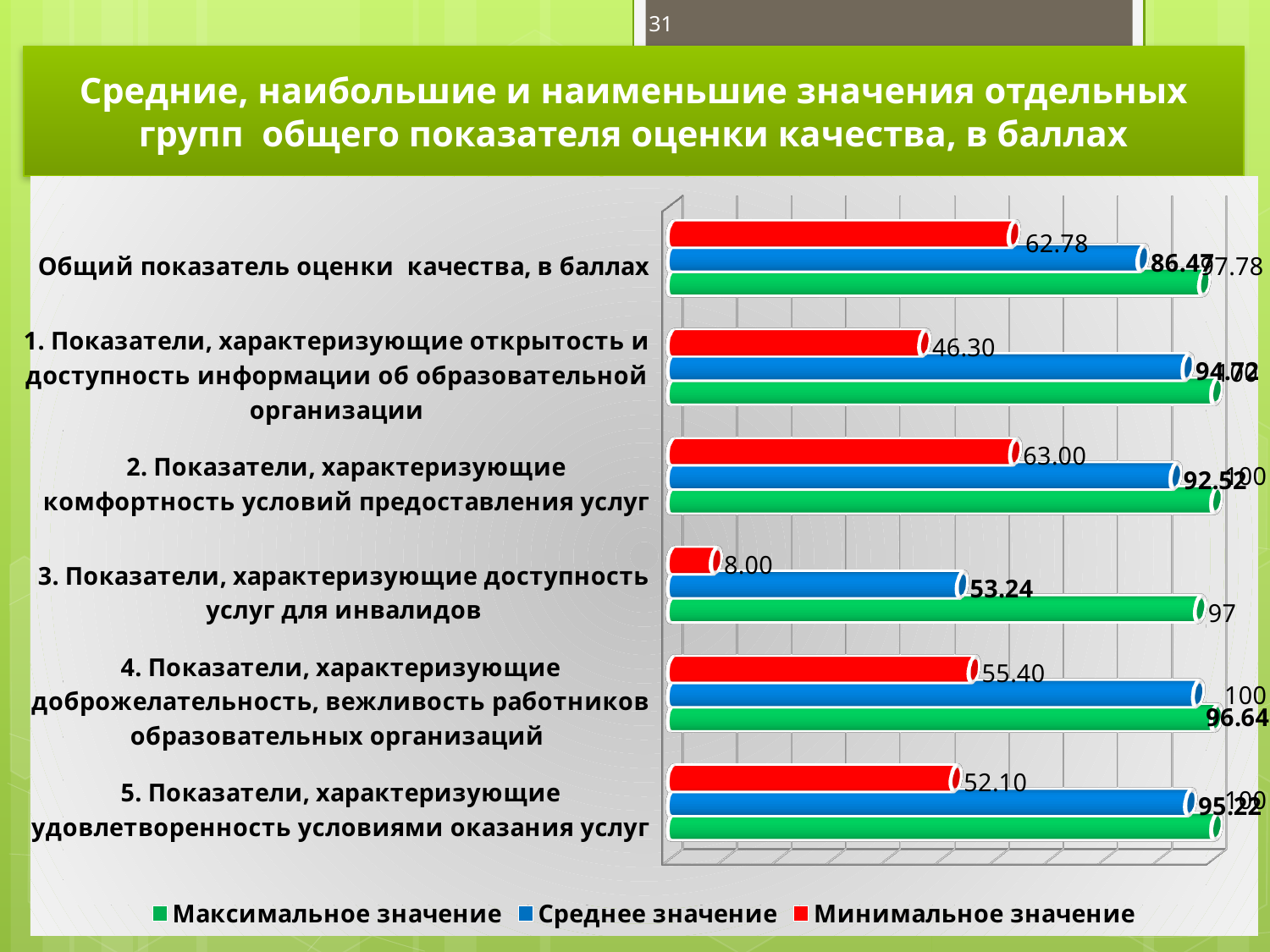
What is the maximum value (Максимальное значение) for '3. Показатели, характеризующие доступность услуг для инвалидов'? 97 Which is larger: the minimum value for category 1 (открытость и доступность информации) or for category 5 (удовлетворенность условиями оказания услуг)? Category 5 (52.10) Which category has the highest minimum value (Минимальное значение)? 2. Показатели, характеризующие комфортность условий предоставления услуг What kind of chart is shown on the slide? Bar chart How many series does the legend list? 3 How many categories are shown on the chart? 6 What is the minimum value (Минимальное значение) for 'Общий показатель оценки качества, в баллах'? 62.78 What is the minimum value (Минимальное значение) for '3. Показатели, характеризующие доступность услуг для инвалидов'? 8.00 What is the difference between the maximum and minimum values for '3. Показатели, характеризующие доступность услуг для инвалидов'? 89 What is the minimum value (Минимальное значение) for '1. Показатели, характеризующие открытость и доступность информации об образовательной организации'? 46.30 Which category has the lowest minimum value (Минимальное значение)? 3. Показатели, характеризующие доступность услуг для инвалидов What is the average value (Среднее значение) for '4. Показатели, характеризующие доброжелательность, вежливость работников образовательных организаций'? 96.64